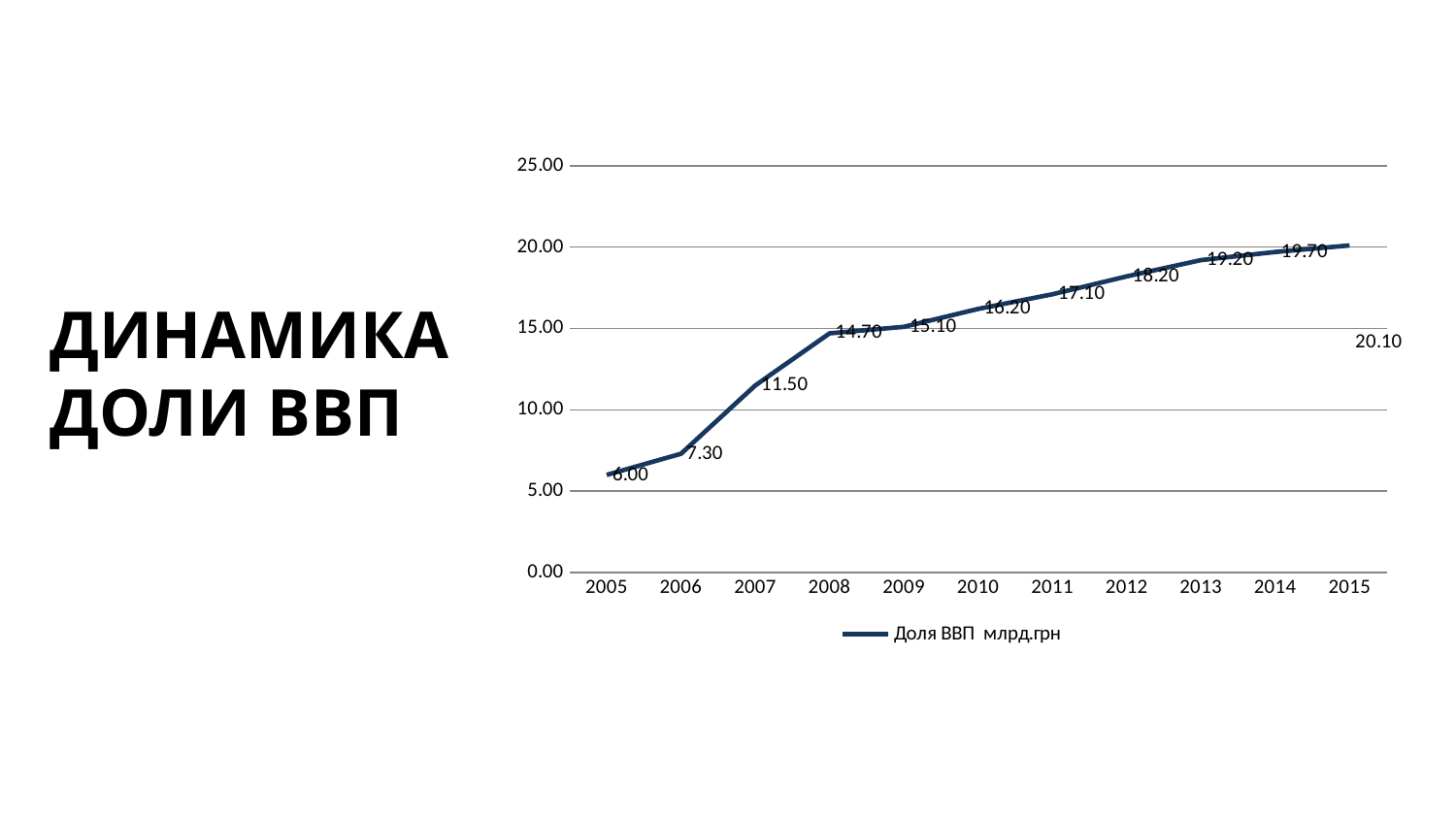
What kind of chart is shown? line chart Which is larger, the value for 2009 or the value for 2010? 2010 What is the value for 2008? 14.70 What is the value for 2005? 6.00 What is the difference between the values for 2007 and 2006? 4.20 How many years are plotted on the x axis? 11 Which year has the highest value? 2015 Is the value for 2013 greater or less than 15.00? greater What is the value for 2015? 20.10 Which year has the lowest value? 2005 What is the value for 2011? 17.10 Do the values rise or fall from 2005 to 2015? rise